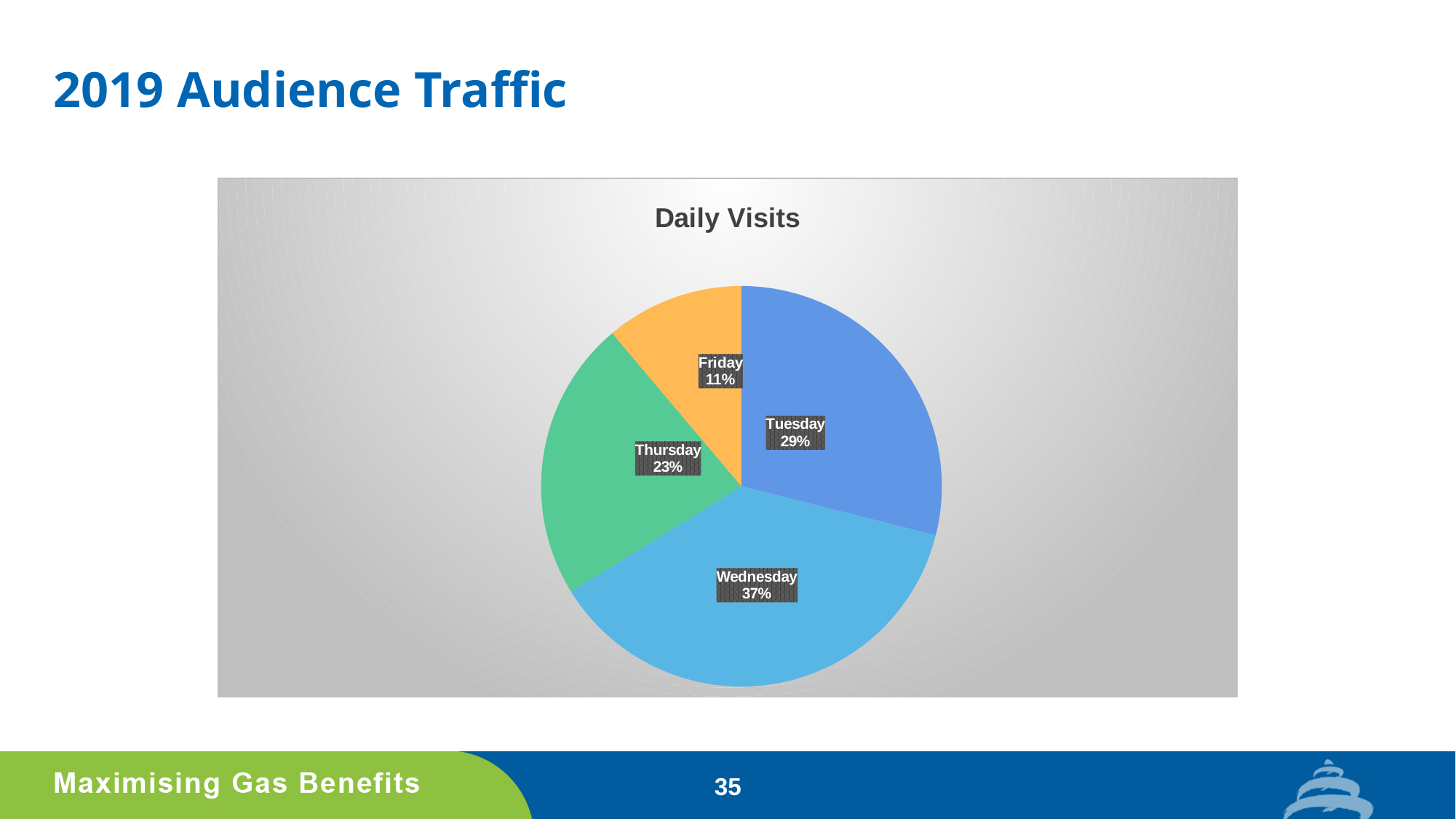
How many days are shown in the pie chart? 4 What is the difference in percentage points between Wednesday's and Tuesday's shares? 8 Which has a larger share of daily visits, Thursday or Friday? Thursday What is the title of the chart? Daily Visits Which day has the smallest share of daily visits? Friday What colour is the Wednesday slice? Light blue What share of daily visits does Wednesday account for? 37% Which day has the largest share of daily visits? Wednesday What share of daily visits does Friday account for? 11% What share of daily visits does Tuesday account for? 29% What kind of chart is shown on the slide? Pie chart